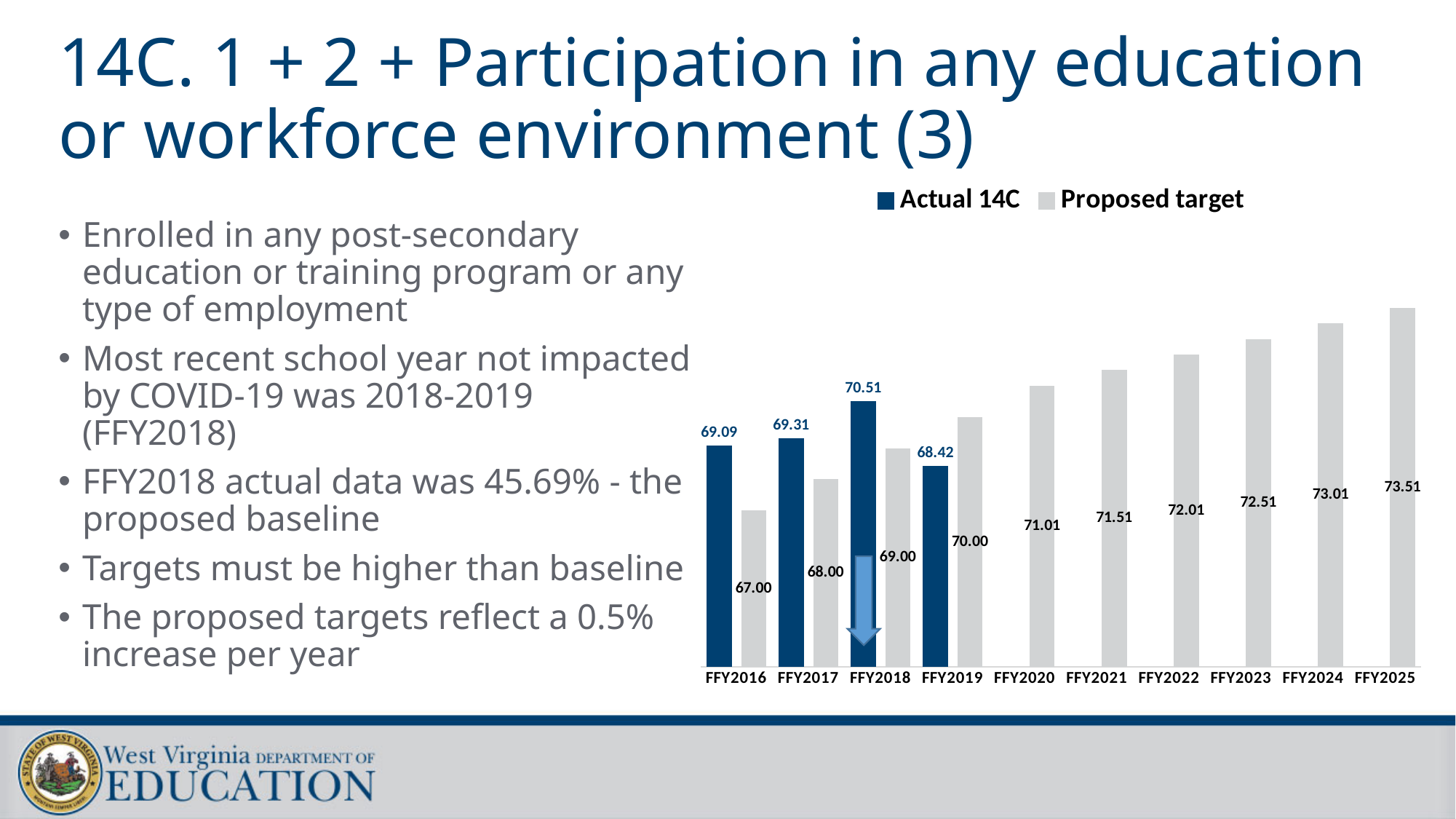
Which year has the lowest Proposed target? FFY2016 Which year has the highest Actual 14C value? FFY2018 Do the Proposed target values rise or fall from FFY2016 to FFY2025? Rise Which is larger for FFY2017, the Actual 14C value or the Proposed target? Actual 14C What is the Proposed target for FFY2025? 73.51 What is the Actual 14C value for FFY2019? 68.42 How many series does the legend list? 2 What is the difference between the Actual 14C value and the Proposed target for FFY2019? 1.58 What kind of chart is shown on the slide? Bar chart What is the Actual 14C value for FFY2018? 70.51 What is the Proposed target for FFY2016? 67.00 How many years are shown on the x axis? 10